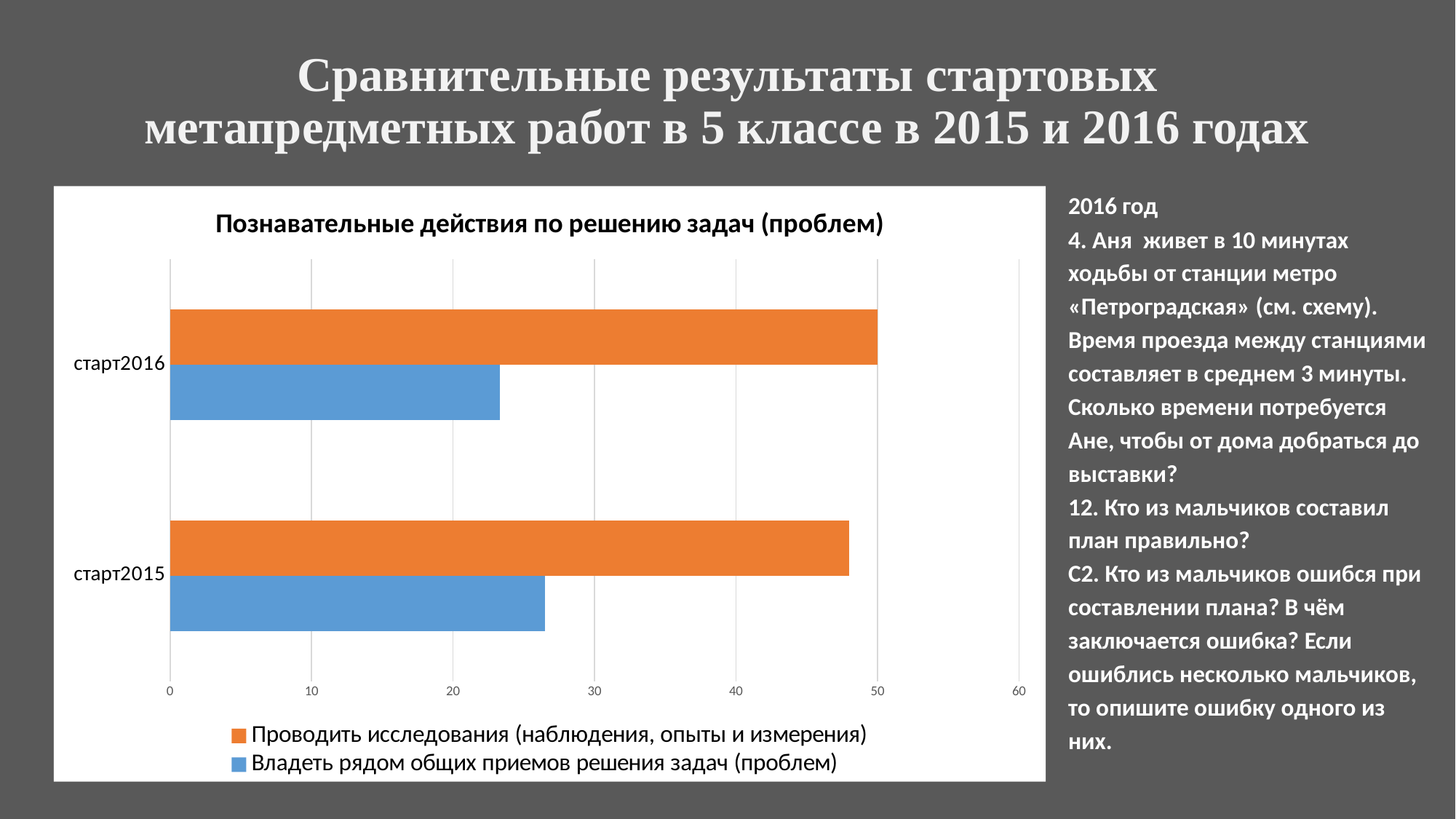
What kind of chart is shown on the slide? bar chart For the series 'Владеть рядом общих приемов решения задач (проблем)', which category has the larger value: старт2015 or старт2016? старт2015 How many categories are shown on the vertical axis of the chart? 2 Which colour represents the series 'Владеть рядом общих приемов решения задач (проблем)'? blue Is the value for 'Владеть рядом общих приемов решения задач (проблем)' in старт2016 greater or less than 30? less Is the value for 'Проводить исследования (наблюдения, опыты и измерения)' in старт2016 greater or less than 40? greater What is the title of the chart? Познавательные действия по решению задач (проблем) Is the value for 'Проводить исследования (наблюдения, опыты и измерения)' in старт2015 greater or less than 40? greater How many series does the chart legend list? 2 For the series 'Проводить исследования (наблюдения, опыты и измерения)', which category has the lower value: старт2015 or старт2016? старт2015 For старт2016, which series has the larger value: 'Проводить исследования (наблюдения, опыты и измерения)' or 'Владеть рядом общих приемов решения задач (проблем)'? Проводить исследования (наблюдения, опыты и измерения)